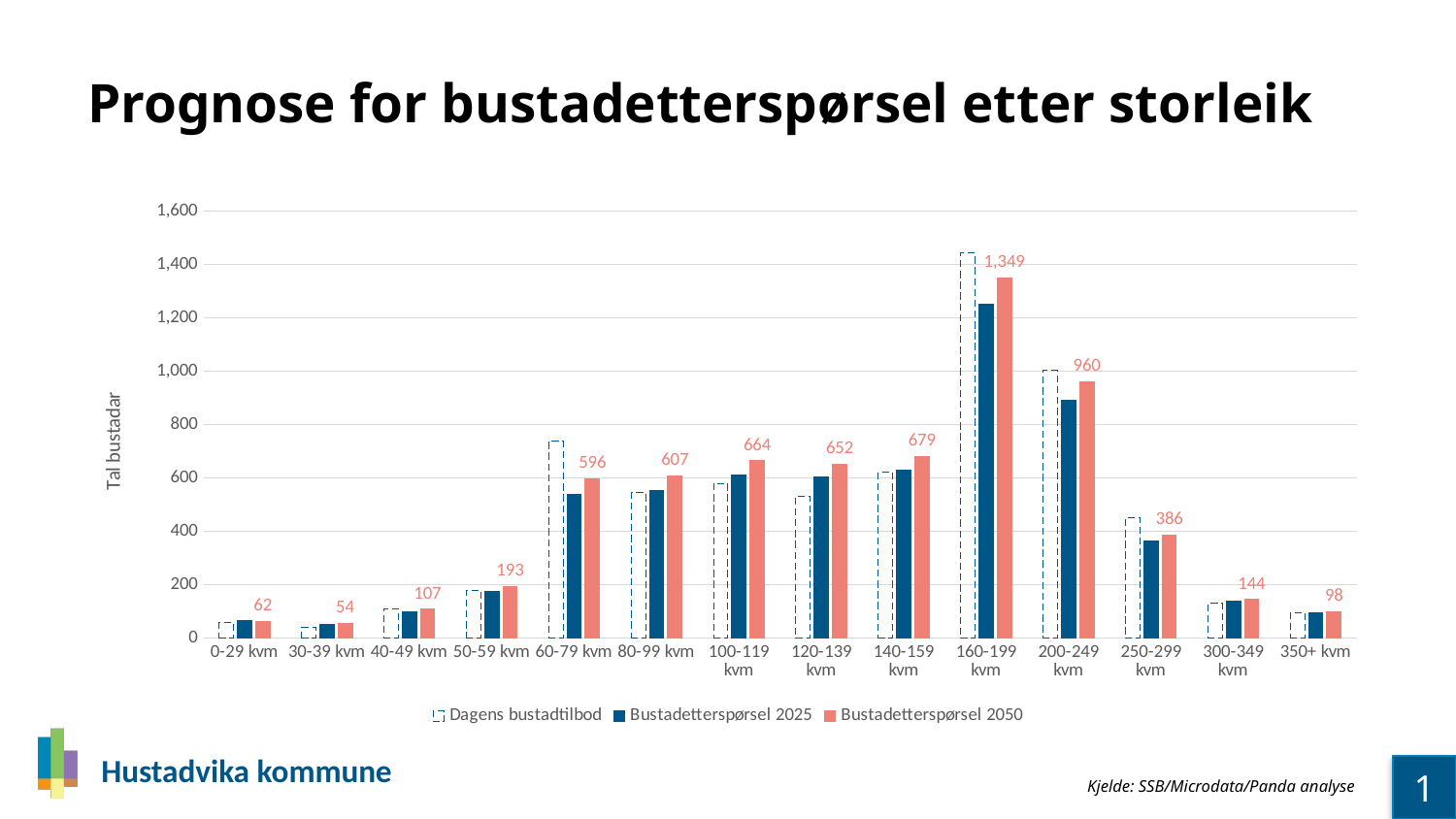
What kind of chart is shown on the slide? Bar chart How many size categories are shown on the x axis? 14 Is the Dagens bustadtilbod value for 250-299 kvm greater or less than 600? less What is the Bustadetterspørsel 2050 value for the 160-199 kvm category? 1,349 Which category has the lowest Bustadetterspørsel 2050 value? 30-39 kvm Which category has the highest Bustadetterspørsel 2050 value? 160-199 kvm How many series does the legend list? 3 Which is larger, the Bustadetterspørsel 2050 value for 100-119 kvm or for 120-139 kvm? 100-119 kvm What is the Bustadetterspørsel 2050 value for the 300-349 kvm category? 144 What is the difference between the Bustadetterspørsel 2050 values for 160-199 kvm and 200-249 kvm? 389 Is the Bustadetterspørsel 2025 value for 160-199 kvm greater or less than 1,200? greater What is the Bustadetterspørsel 2050 value for the 50-59 kvm category? 193